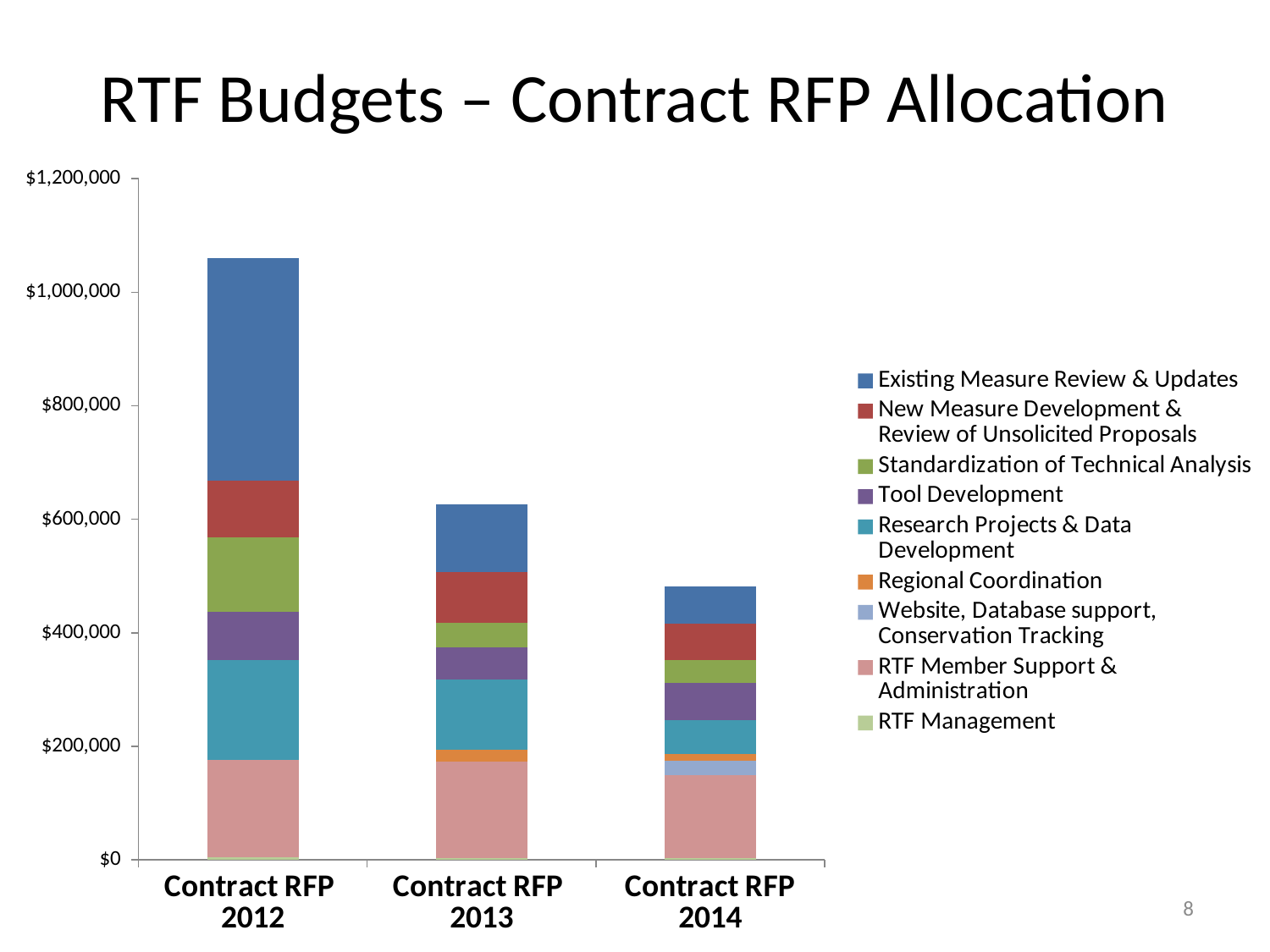
What is the title of the slide? RTF Budgets – Contract RFP Allocation Do the total bar heights rise or fall from Contract RFP 2012 to Contract RFP 2014? fall Which series is listed first in the legend? Existing Measure Review & Updates What kind of chart is shown on the slide? stacked bar chart How many series does the legend list? 9 Is the total for Contract RFP 2013 greater or less than $600,000? greater Is the total for Contract RFP 2014 greater or less than $600,000? less Which is larger, the total for Contract RFP 2013 or the total for Contract RFP 2014? Contract RFP 2013 Which category has the shortest stacked bar? Contract RFP 2014 Is the total for Contract RFP 2012 greater or less than $1,000,000? greater Which category has the tallest stacked bar? Contract RFP 2012 How many bars (categories) are shown on the x axis? 3